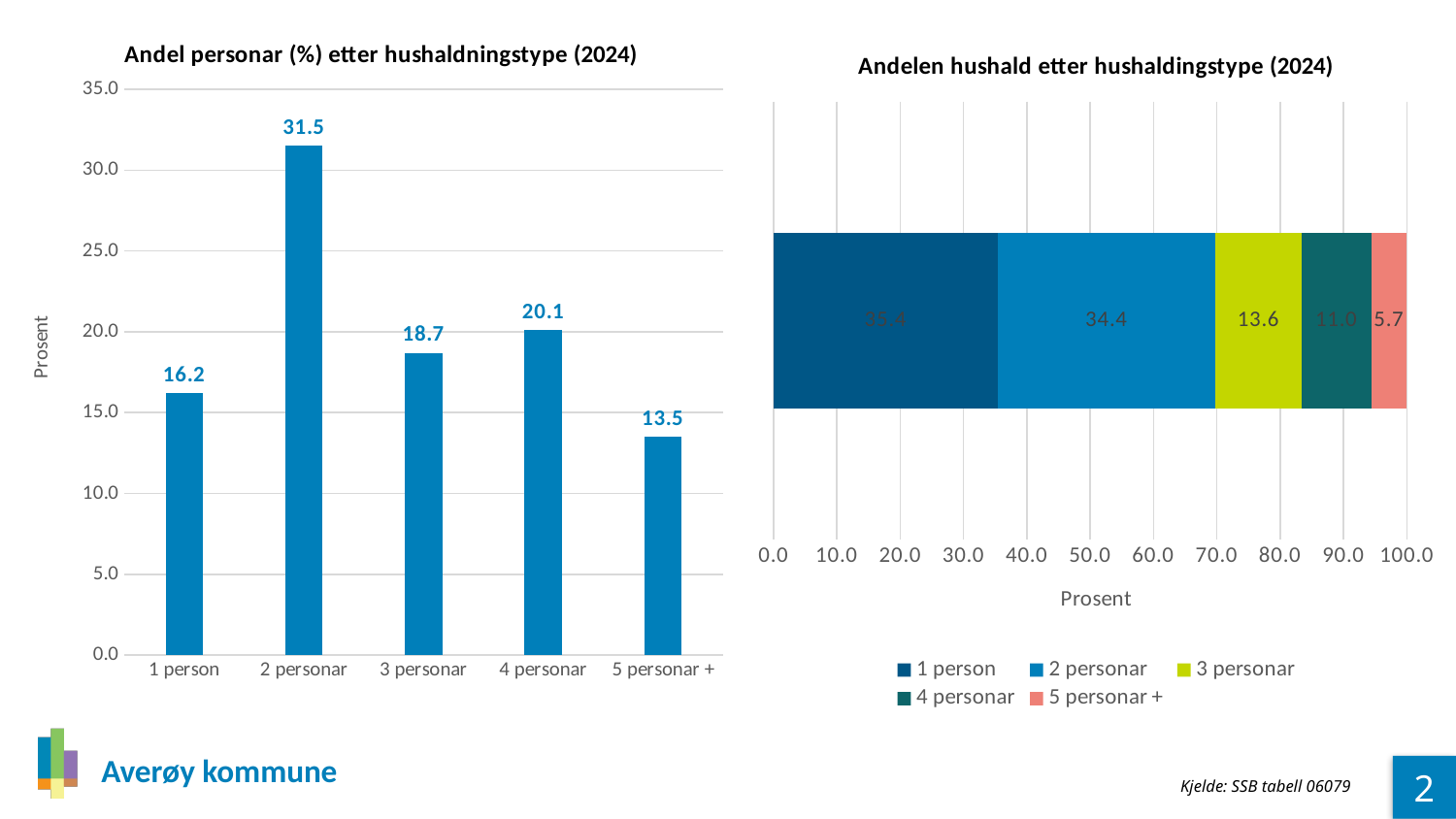
What kind of chart is the left chart 'Andel personar (%) etter hushaldningstype (2024)'? Bar chart In the left chart 'Andel personar (%) etter hushaldningstype (2024)', which category has the highest value? 2 personar In the left chart 'Andel personar (%) etter hushaldningstype (2024)', what is the difference between the values for 2 personar and 1 person? 15.3 In the left chart 'Andel personar (%) etter hushaldningstype (2024)', what is the value for 5 personar +? 13.5 In the left chart 'Andel personar (%) etter hushaldningstype (2024)', what is the value for 2 personar? 31.5 In the right chart 'Andelen hushald etter hushaldingstype (2024)', what is the value for 5 personar +? 5.7 In the left chart 'Andel personar (%) etter hushaldningstype (2024)', which is larger, the value for 3 personar or 4 personar? 4 personar In the right chart 'Andelen hushald etter hushaldingstype (2024)', what is the value for 2 personar? 34.4 In the right chart 'Andelen hushald etter hushaldingstype (2024)', what is the axis title on the horizontal axis? Prosent In the left chart 'Andel personar (%) etter hushaldningstype (2024)', how many categories are shown on the x axis? 5 In the right chart 'Andelen hushald etter hushaldingstype (2024)', how many series does the legend list? 5 In the left chart 'Andel personar (%) etter hushaldningstype (2024)', which category has the lowest value? 5 personar +